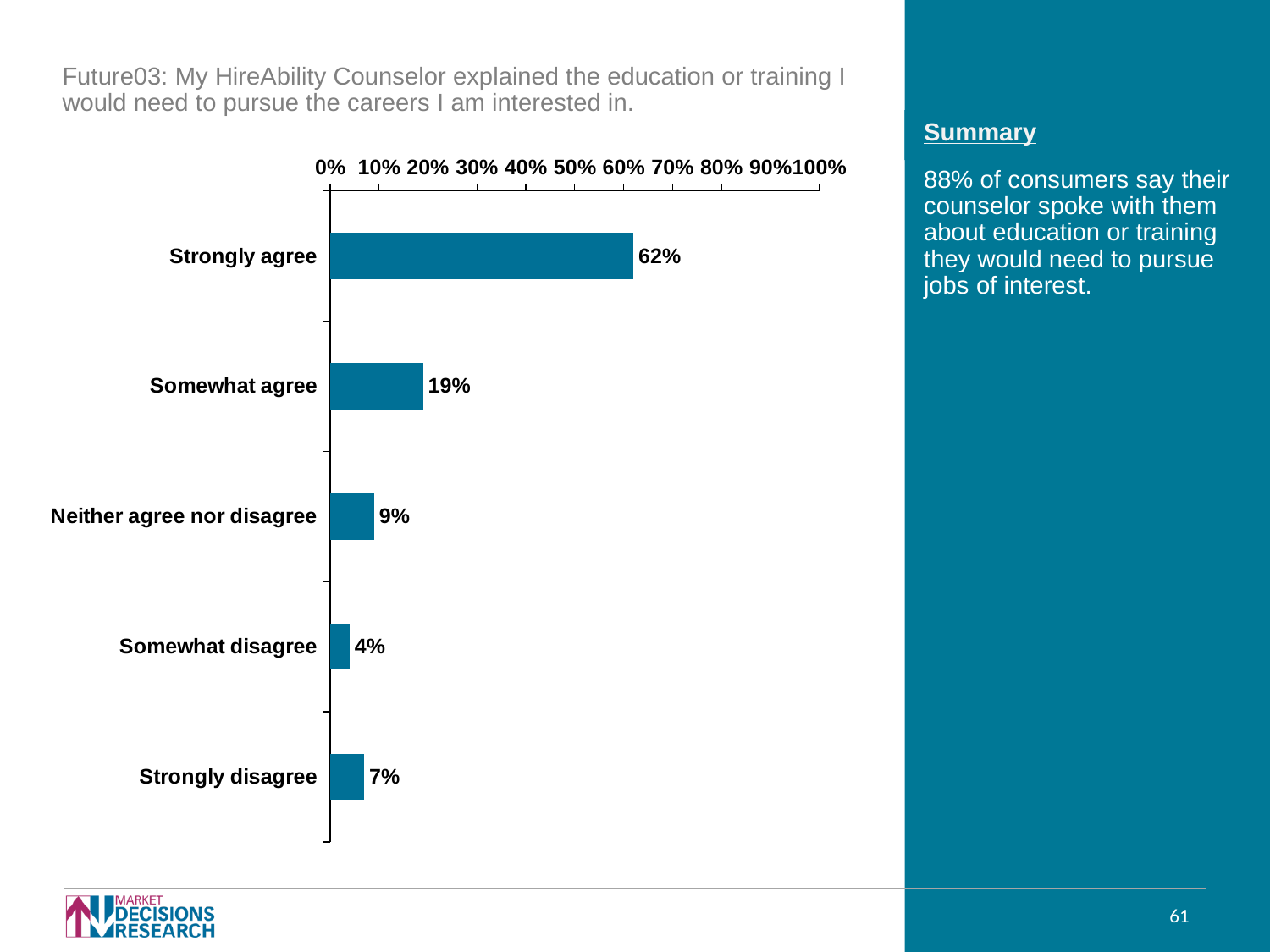
Which is larger, Strongly disagree or Somewhat disagree? Strongly disagree What is the value for Neither agree nor disagree? 9% What is the value for Somewhat agree? 19% How many categories are shown in the chart? 5 Which category has the lowest value? Somewhat disagree What is the difference between Strongly agree and Somewhat agree? 43% Which category has the highest value? Strongly agree What is the value for Strongly disagree? 7% What is the combined value of Strongly agree and Somewhat agree? 81% What percentage of respondents strongly agree? 62% What kind of chart is shown on the slide? Bar chart Is the value for Strongly agree greater or less than 50%? greater